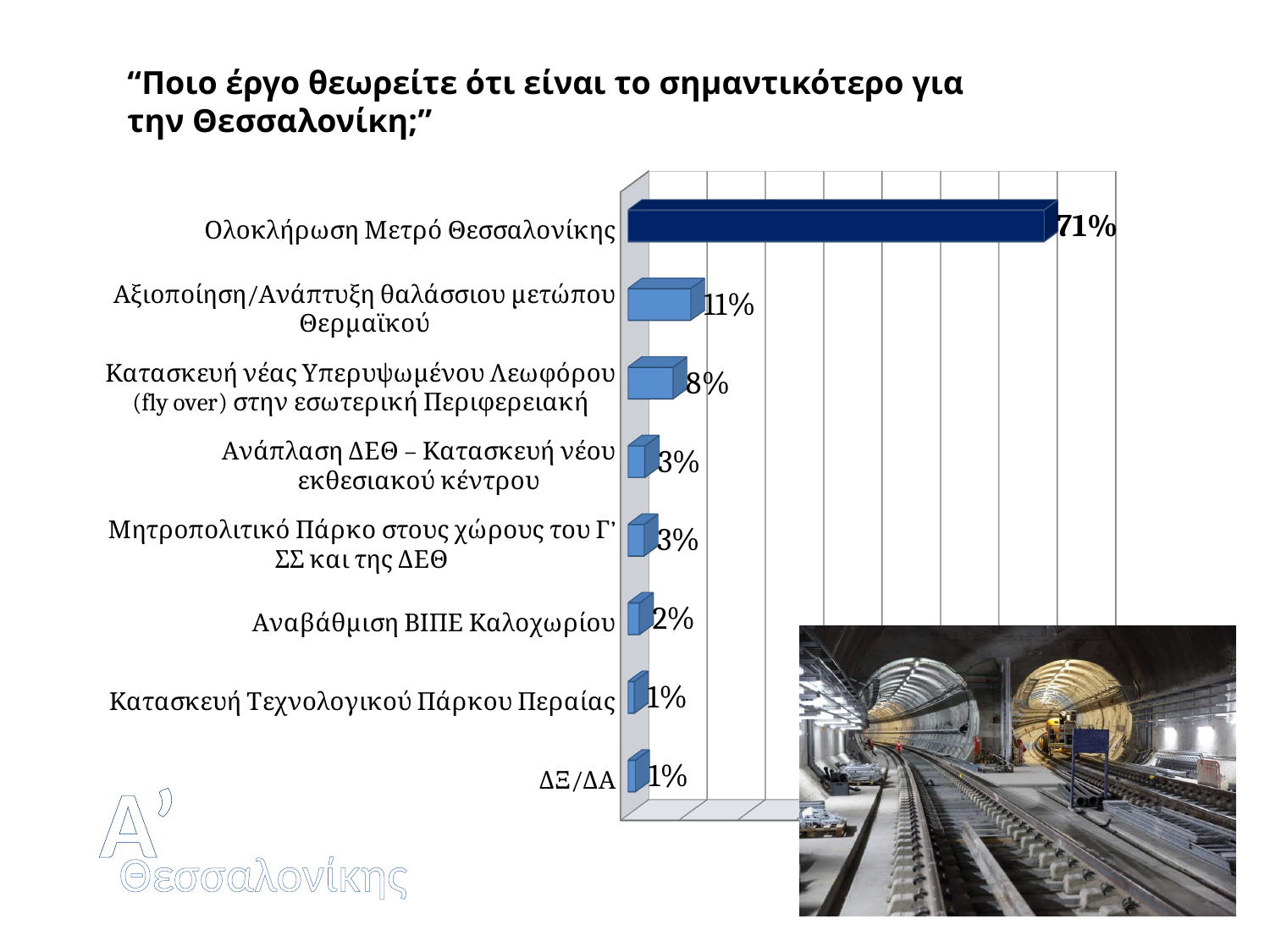
What value is shown for ΔΞ/ΔΑ? 1% Which has a larger value: Αξιοποίηση/Ανάπτυξη θαλάσσιου μετώπου Θερμαϊκού or Κατασκευή νέας Υπερυψωμένου Λεωφόρου (fly over)? Αξιοποίηση/Ανάπτυξη θαλάσσιου μετώπου Θερμαϊκού What question is the chart answering, according to the slide title? “Ποιο έργο θεωρείτε ότι είναι το σημαντικότερο για την Θεσσαλονίκη;” What percentage of respondents chose Ολοκλήρωση Μετρό Θεσσαλονίκης as the most important project? 71% How many categories (projects/answers) are shown in the chart? 8 What type of chart is shown on the slide? Bar chart What is the difference between the values for the fly over project and Ανάπλαση ΔΕΘ – Κατασκευή νέου εκθεσιακού κέντρου? 5 percentage points Which project has the highest percentage in the chart? Ολοκλήρωση Μετρό Θεσσαλονίκης What is the value shown for Αξιοποίηση/Ανάπτυξη θαλάσσιου μετώπου Θερμαϊκού? 11% What value is shown for the fly over on the εσωτερική Περιφερειακή? 8% What percentage is shown for Αναβάθμιση ΒΙΠΕ Καλοχωρίου? 2% What is the difference in percentage points between Ολοκλήρωση Μετρό Θεσσαλονίκης and Αξιοποίηση/Ανάπτυξη θαλάσσιου μετώπου Θερμαϊκού? 60 percentage points